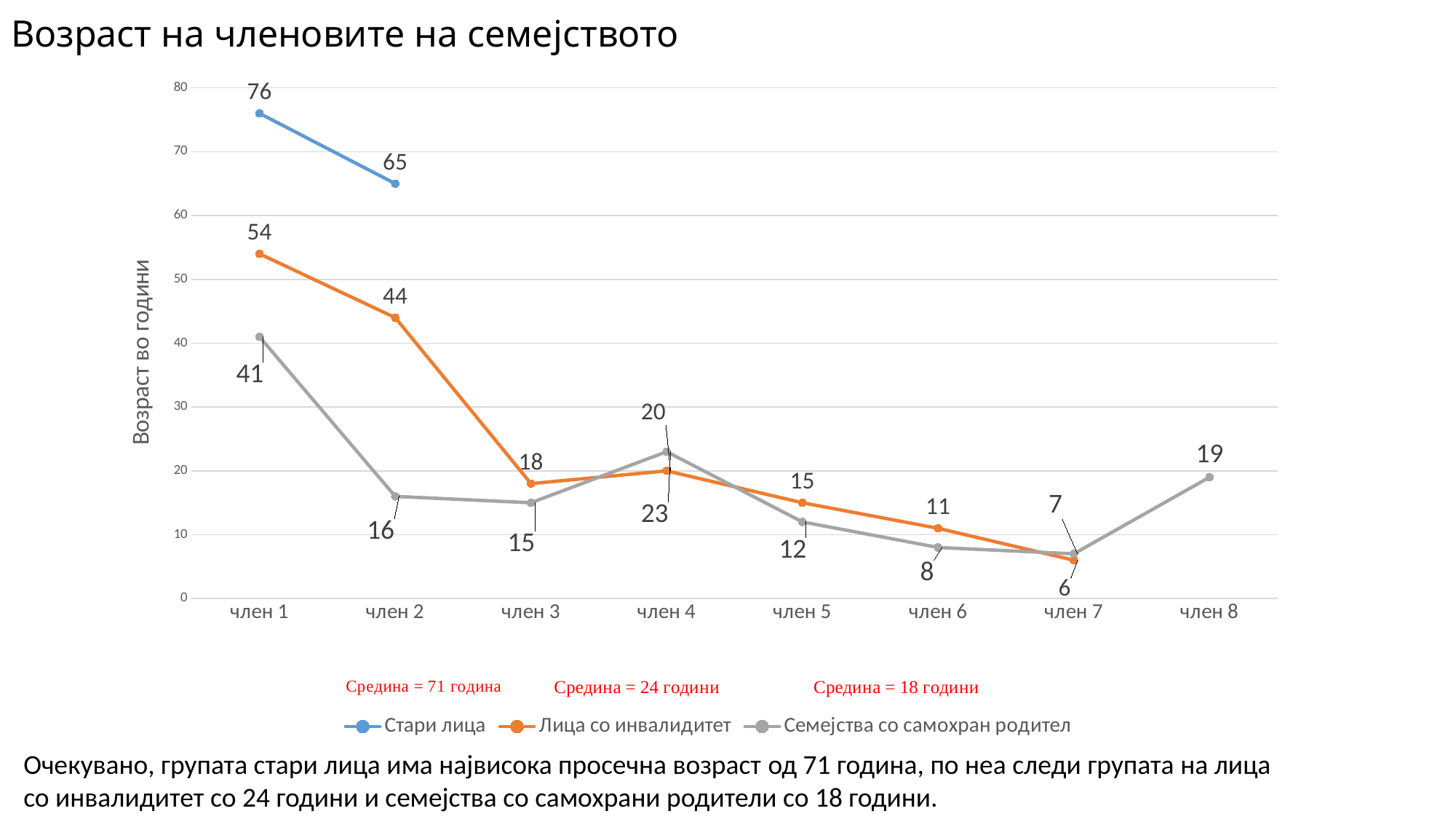
Which member has the lowest value in the Лица со инвалидитет series? член 7 What is the value for член 8 in the Семејства со самохран родител series? 19 How many series does the legend list? 3 Which member has the highest value in the Семејства со самохран родител series? член 1 Does the Лица со инвалидитет series generally rise or fall from член 1 to член 7? fall At член 4, which series has the larger value: Лица со инвалидитет or Семејства со самохран родител? Семејства со самохран родител How many categories (members) are shown on the x axis? 8 What is the value for член 1 in the Стари лица series? 76 What kind of chart is shown on the slide? line chart What is the value for член 2 in the Лица со инвалидитет series? 44 What is the difference between the Стари лица values for член 1 and член 2? 11 What is the title of the chart? Возраст на членовите на семејството